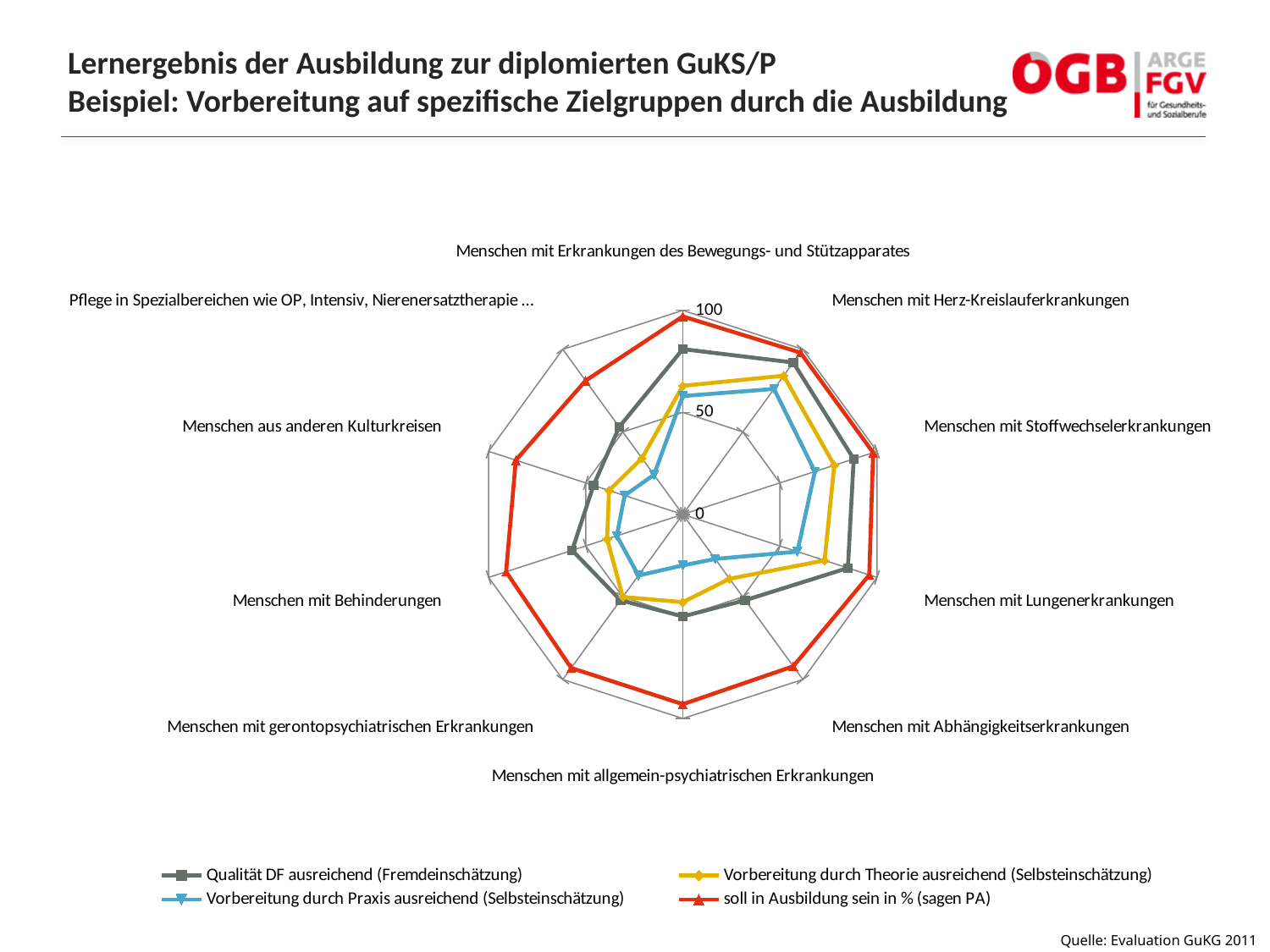
Is the value of 'Vorbereitung durch Praxis ausreichend (Selbsteinschätzung)' for 'Menschen mit allgemein-psychiatrischen Erkrankungen' greater or less than 50? less How many series does the legend list? 4 Is the value of 'soll in Ausbildung sein in % (sagen PA)' for 'Menschen mit Behinderungen' greater or less than 50? greater How many categories (axes) does the radar chart have? 10 Is the value of 'Vorbereitung durch Praxis ausreichend (Selbsteinschätzung)' for 'Menschen mit Behinderungen' greater or less than 50? less For 'Menschen mit Erkrankungen des Bewegungs- und Stützapparates', which is larger: 'Qualität DF ausreichend (Fremdeinschätzung)' or 'Vorbereitung durch Praxis ausreichend (Selbsteinschätzung)'? Qualität DF ausreichend (Fremdeinschätzung) What is the highest value shown on the radar chart's axis scale? 100 What kind of chart is shown on the slide? radar chart For 'Menschen aus anderen Kulturkreisen', which is larger: 'soll in Ausbildung sein in % (sagen PA)' or 'Vorbereitung durch Praxis ausreichend (Selbsteinschätzung)'? soll in Ausbildung sein in % (sagen PA) What colour is the line for the series 'soll in Ausbildung sein in % (sagen PA)'? red